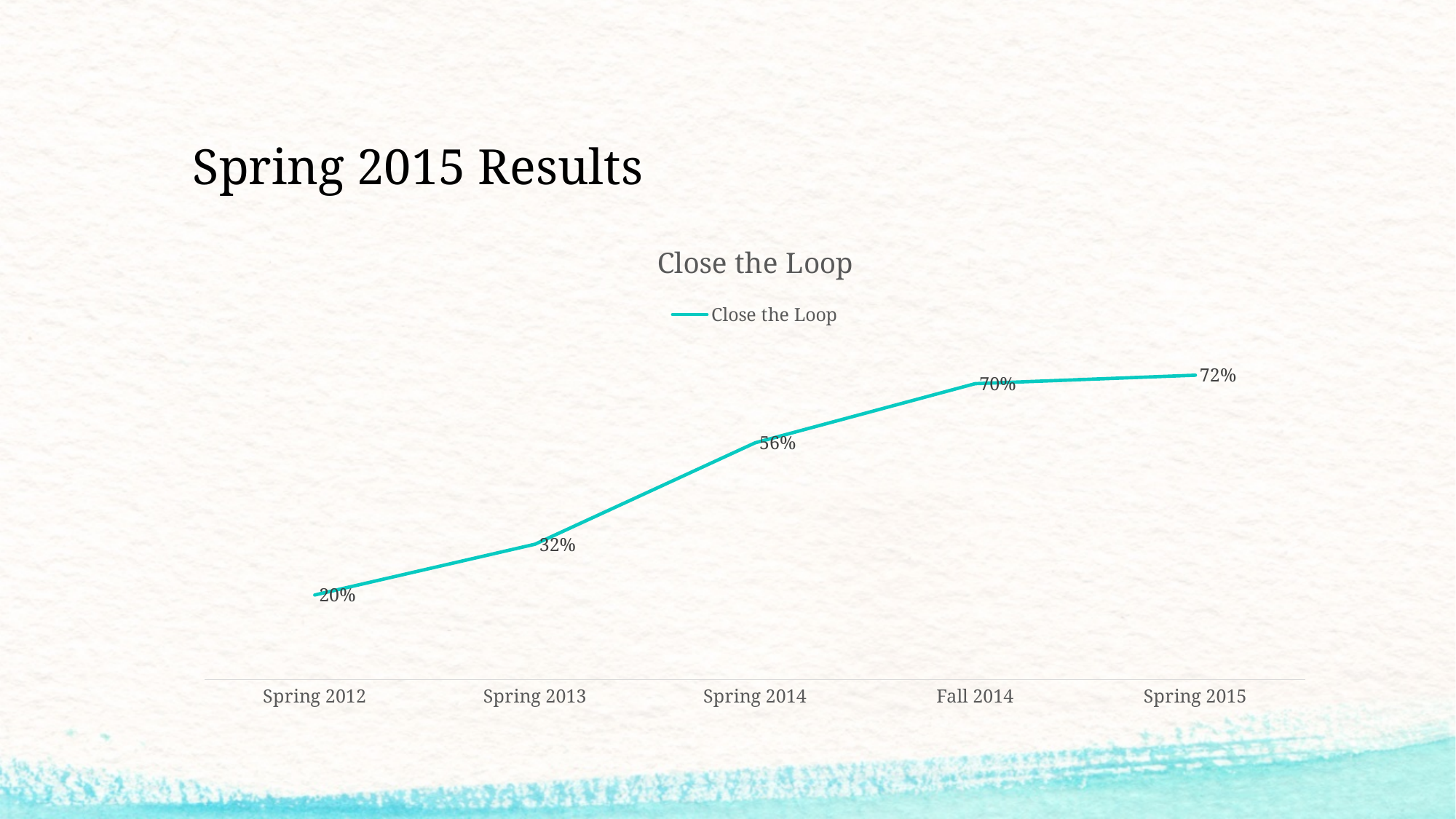
What is the difference between the values for Spring 2014 and Spring 2013? 24% Do the values rise or fall from Spring 2012 to Spring 2015? Rise What kind of chart is shown? Line chart What is the value for Spring 2012? 20% How many periods are plotted on the x axis? 5 What is the value for Fall 2014? 70% What is the value for Spring 2013? 32% Which period has the lowest value? Spring 2012 Which period has the highest value? Spring 2015 What is the value for Spring 2014? 56% What is the value for Spring 2015? 72% Which is larger, the value for Fall 2014 or the value for Spring 2014? Fall 2014